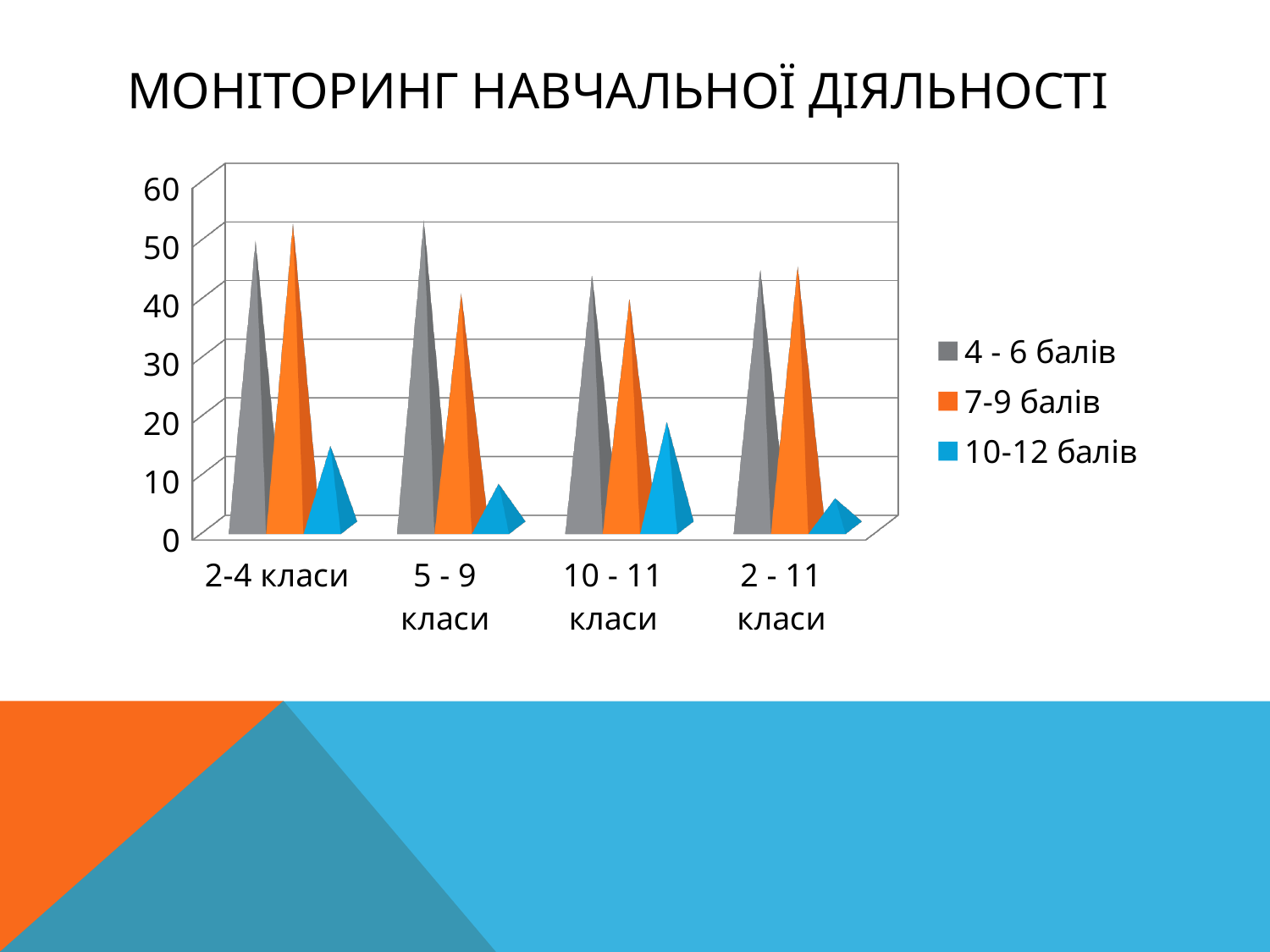
Is the value for 10-12 балів in 2 - 11 класи greater or less than 10? less What kind of chart is shown on the slide? bar chart How many categories are shown on the x axis of the chart? 4 In 5 - 9 класи, which is larger: 4 - 6 балів or 7-9 балів? 4 - 6 балів What is the title of the slide above the chart? МОНІТОРИНГ НАВЧАЛЬНОЇ ДІЯЛЬНОСТІ Which series has the lowest value in 2-4 класи? 10-12 балів Is the value for 7-9 балів in 2-4 класи greater or less than 40? greater Which series is shown in blue in the legend? 10-12 балів Is the value for 10-12 балів in 10 - 11 класи greater or less than 30? less How many series does the chart legend list? 3